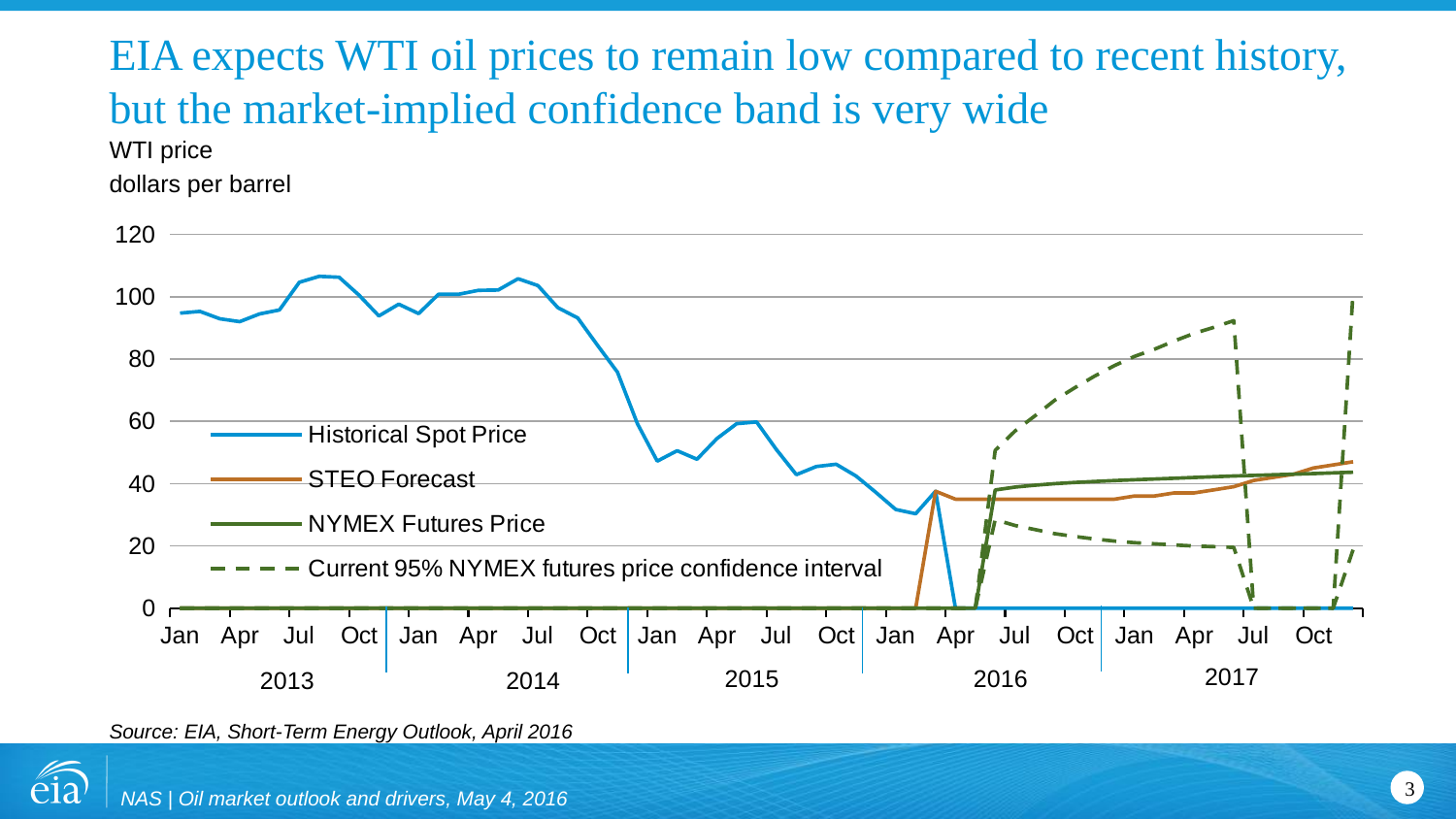
Does the Historical Spot Price rise or fall between Jul 2014 and Jan 2015? fall Which legend entry is drawn as a dashed line? Current 95% NYMEX futures price confidence interval Which is larger: the Historical Spot Price in Jan 2013 or in Jan 2016? Jan 2013 What kind of chart is shown on the slide? line chart Does the STEO Forecast line rise or fall from mid-2016 to the end of 2017? rise Is the Historical Spot Price in Jan 2013 greater or less than 80? greater How many series does the chart's legend list? 4 How many years are labeled along the x axis of the chart? 5 Is the Historical Spot Price in Jan 2016 greater or less than 40? less Is the upper line of the 95% NYMEX futures price confidence interval in Oct 2016 greater or less than 60? greater What unit is the WTI price chart measured in, according to the label above the chart? dollars per barrel